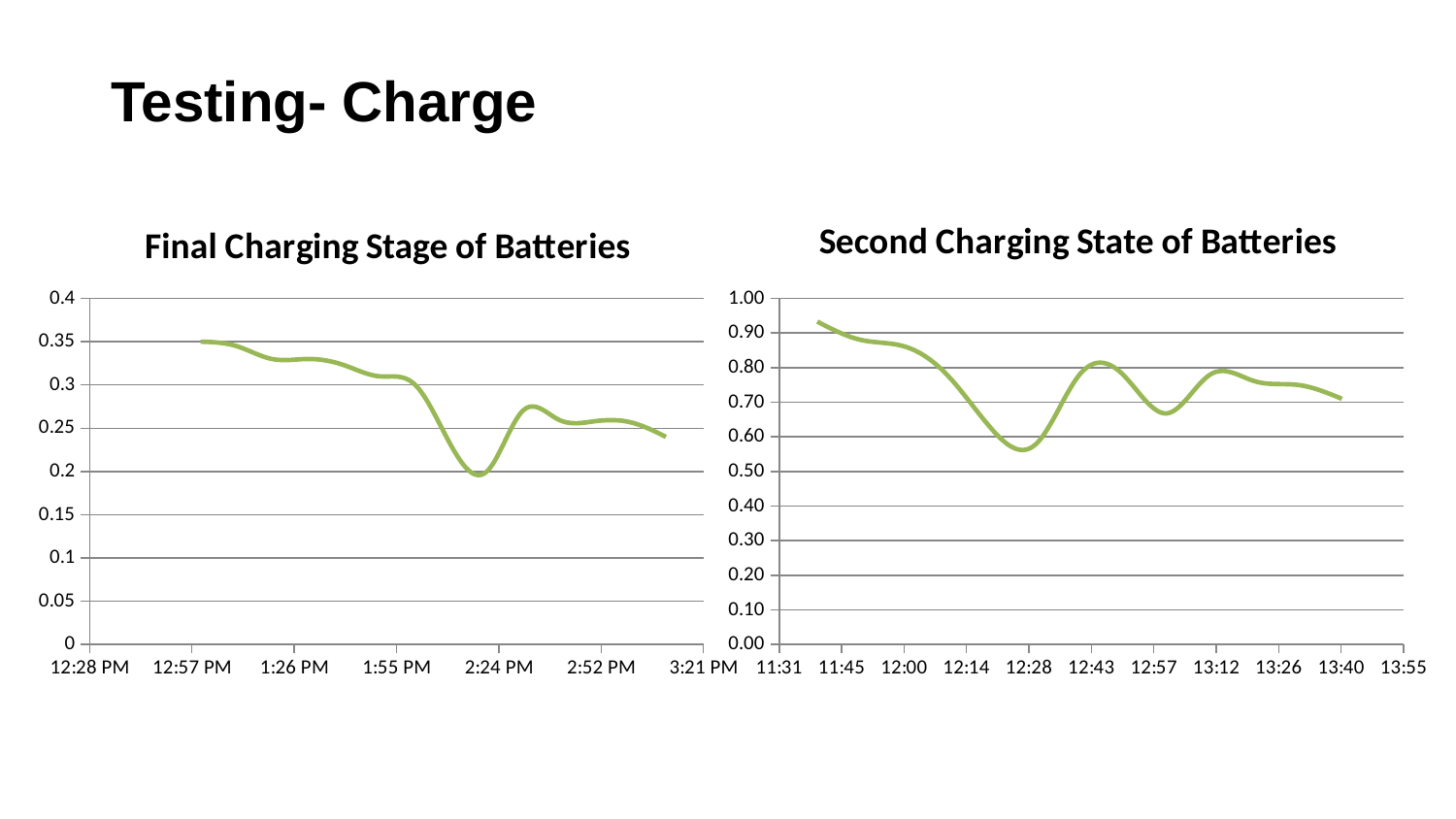
What is the title of the chart on the right of the slide? Second Charging State of Batteries In the "Second Charging State of Batteries" chart, is the lowest point of the line greater or less than 0.70? less In the "Final Charging Stage of Batteries" chart, is the lowest point of the line greater or less than 0.25? less In the "Final Charging Stage of Batteries" chart, do the values overall rise or fall from left to right along the x axis? fall In the "Final Charging Stage of Batteries" chart, is the value at the start of the line greater or less than 0.3? greater What kind of chart is the "Second Charging State of Batteries" chart? line chart What kind of chart is the "Final Charging Stage of Batteries" chart? line chart How many charts are shown on the slide? 2 In the "Second Charging State of Batteries" chart, do the values overall rise or fall from left to right along the x axis? fall What is the title of the chart on the left of the slide? Final Charging Stage of Batteries